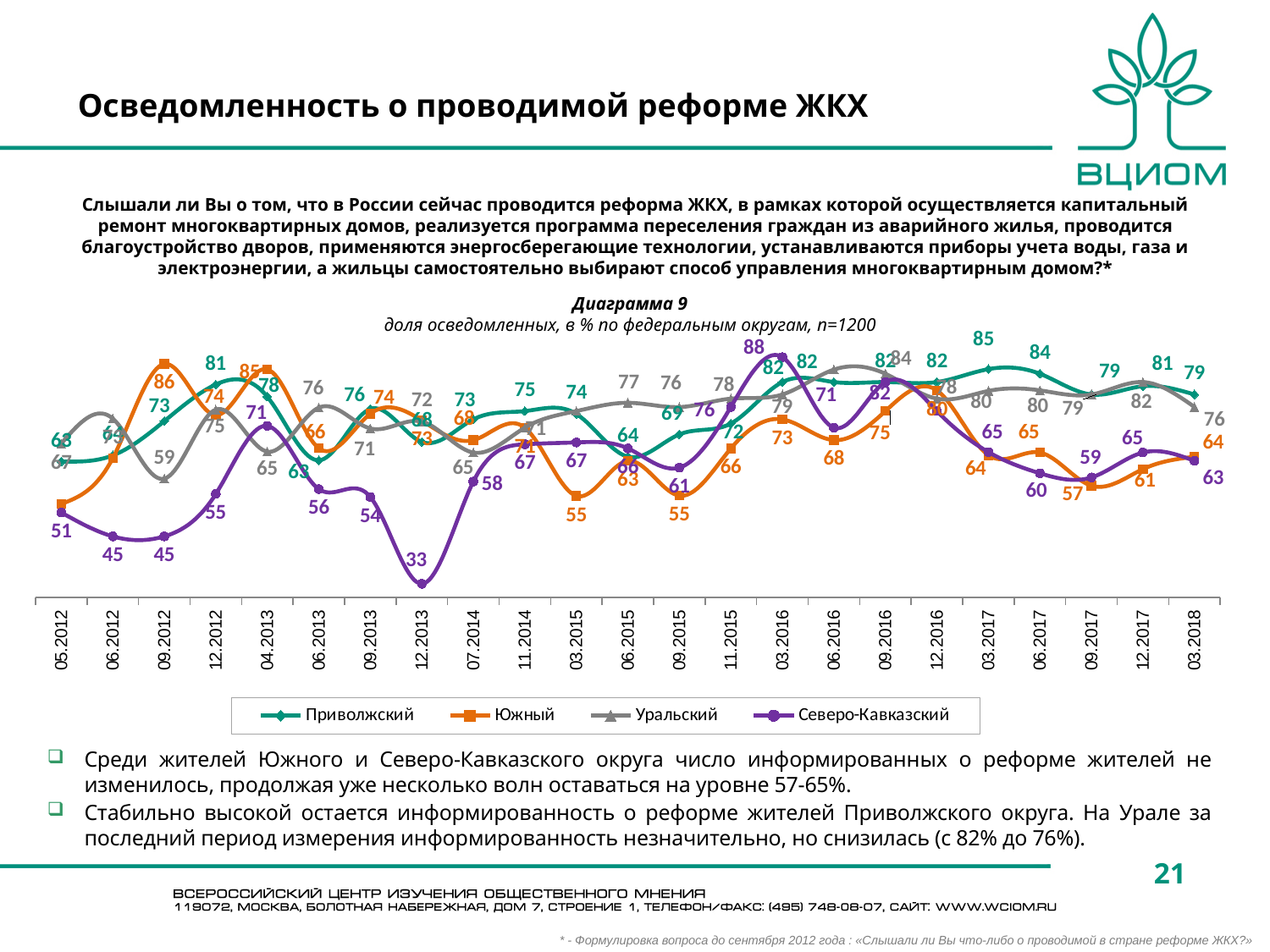
In 03.2018, which series has the larger value: Приволжский or Северо-Кавказский? Приволжский What kind of chart is shown on the slide? line chart What is the difference between the Северо-Кавказский values in 03.2016 and 12.2013? 55 How many series does the legend list? 4 What is the value for Южный in 09.2012? 86 In which period does the Северо-Кавказский series reach its lowest value? 12.2013 How many time points are shown on the x axis? 23 What is the value for Северо-Кавказский in 12.2013? 33 What is the value for Уральский in 03.2018? 76 What is the title of the chart? Диаграмма 9 What is the value for Приволжский in 03.2017? 85 What is the value for Северо-Кавказский in 03.2016? 88